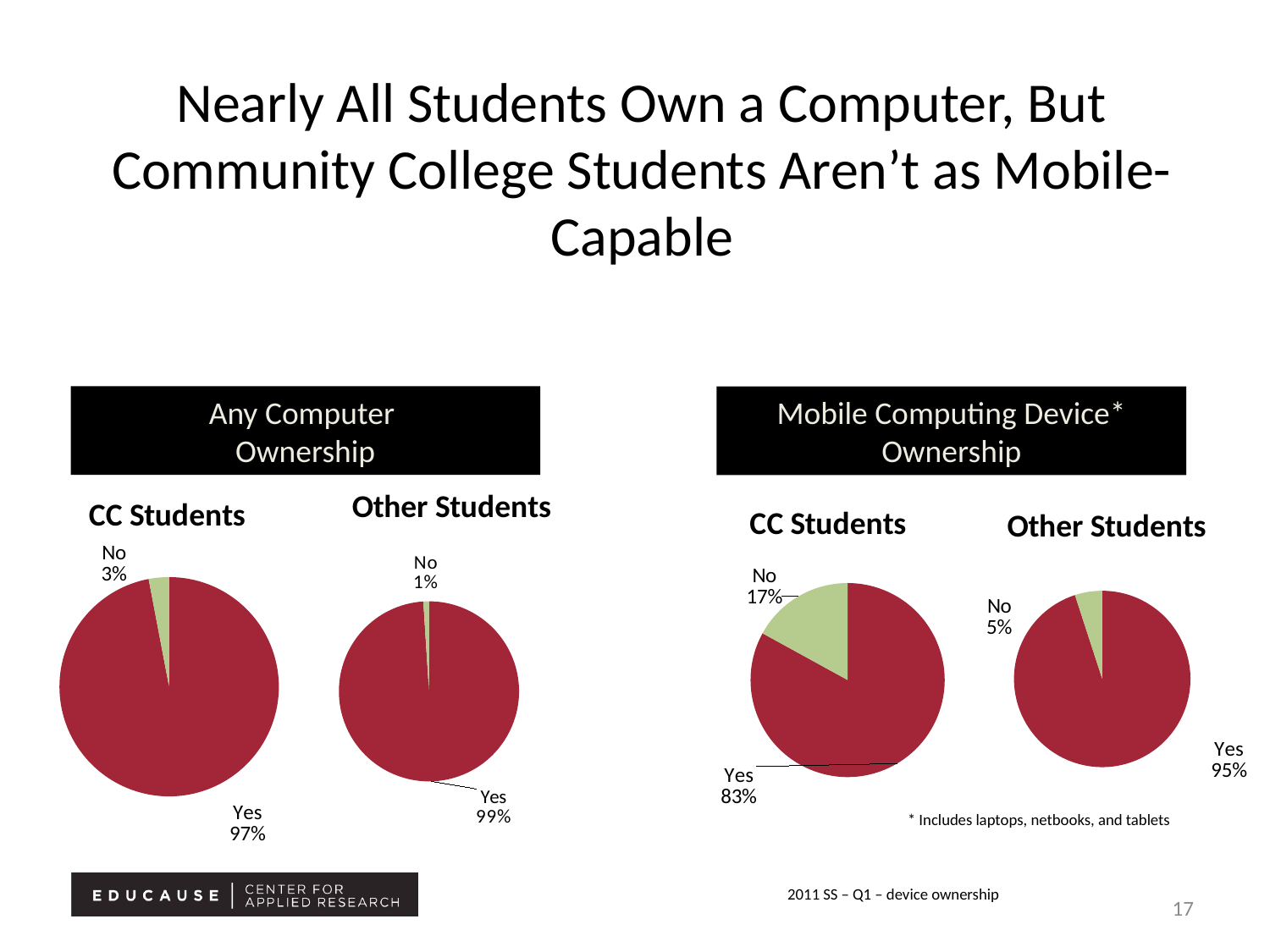
In the Mobile Computing Device Ownership CC Students pie chart, which slice is the largest? Yes In the Any Computer Ownership CC Students pie chart, which slice is the smallest? No What type of chart is used to show Any Computer Ownership for CC Students? Pie chart In the Any Computer Ownership Other Students pie chart, what percentage of students answered No? 1% In the Mobile Computing Device Ownership Other Students pie chart, what percentage of students answered Yes? 95% How many slices does the Mobile Computing Device Ownership Other Students pie chart have? 2 According to the footnote, what does Mobile Computing Device include? Laptops, netbooks, and tablets In the Mobile Computing Device Ownership CC Students pie chart, what percentage of students answered No? 17% What is the difference between the Yes percentage for Other Students and the Yes percentage for CC Students in the Mobile Computing Device Ownership charts? 12% In the Any Computer Ownership CC Students pie chart, what percentage of students answered Yes? 97% Which is larger: the No percentage for CC Students in the Any Computer Ownership chart or the No percentage for CC Students in the Mobile Computing Device Ownership chart? Mobile Computing Device Ownership (17%) How many pie charts are shown on the slide in total? 4